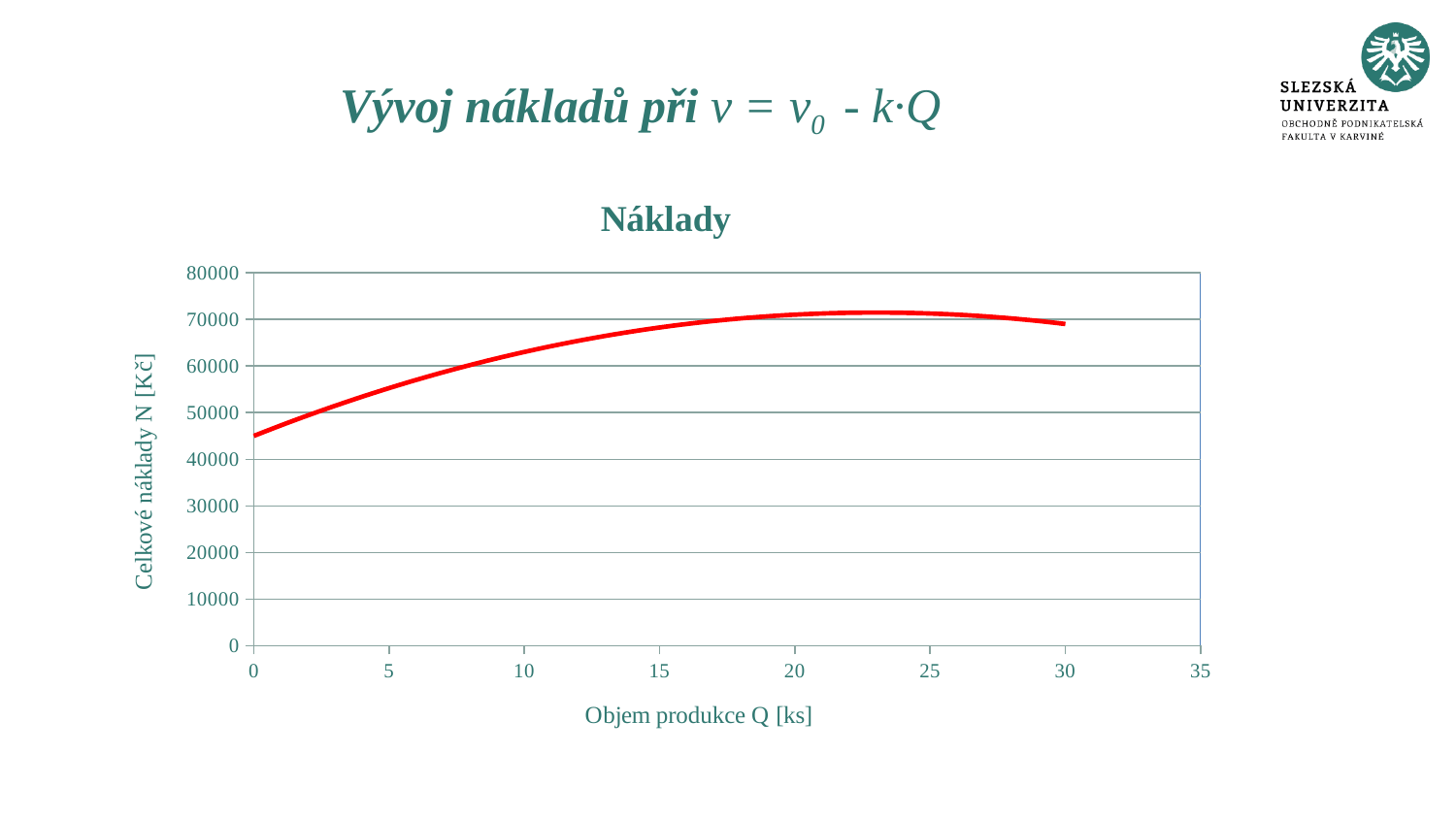
Is the highest point of the curve greater or less than 80000? less What is the label of the x axis of the chart? Objem produkce Q [ks] Is the value of the curve at Q = 30 greater or less than the value at Q = 0? greater Do the costs rise or fall as Q increases from 0 to 15? rise Do the costs rise or fall as Q increases from 25 to 30? fall Is the value of the curve at Q = 0 greater or less than 50000? less Is the value of the curve at Q = 25 greater or less than 60000? greater What kind of chart is shown on the slide? line chart What is the title of the chart? Náklady